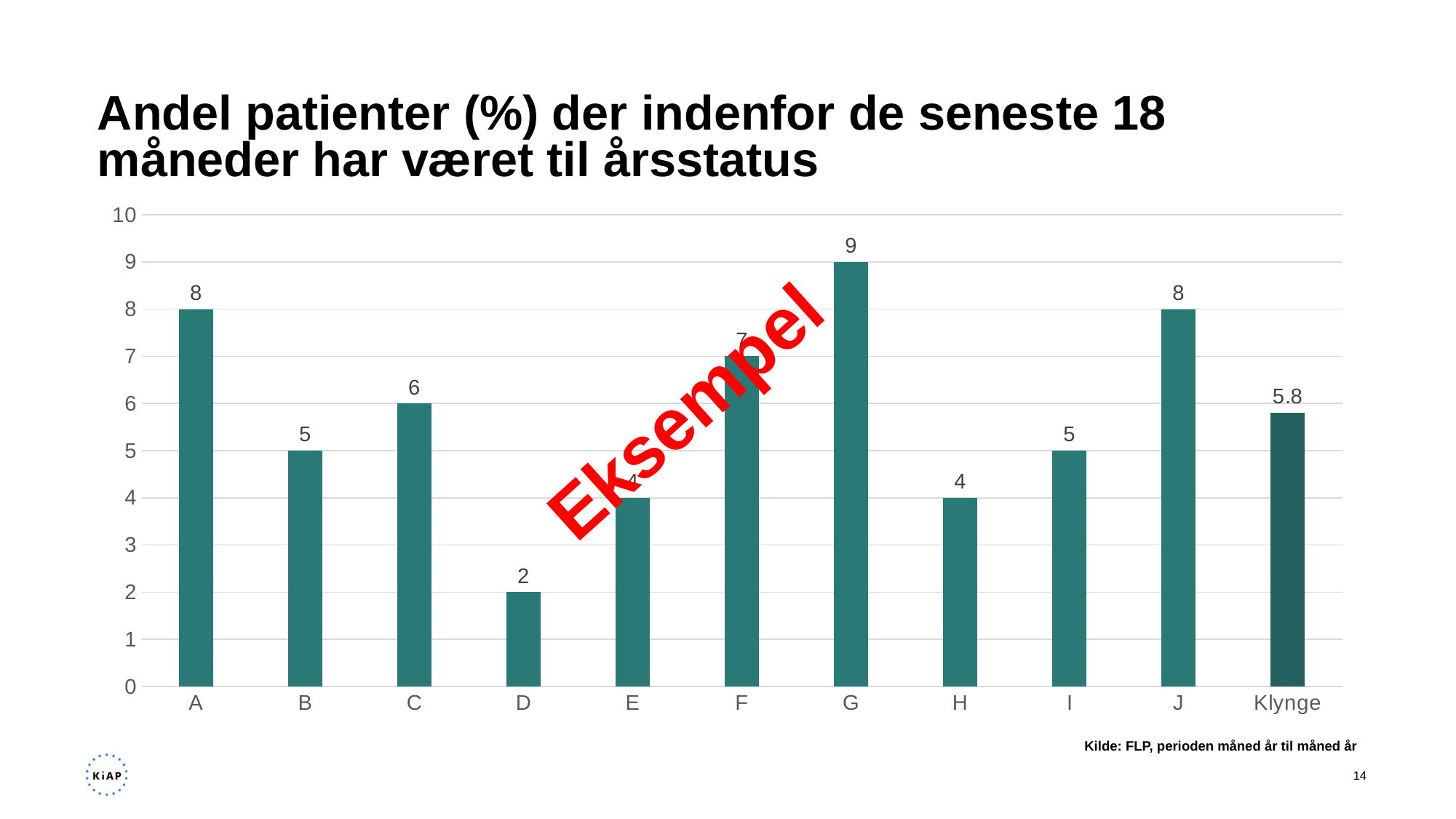
Which is larger, the value for C or the value for H? C What is the title of the chart? Andel patienter (%) der indenfor de seneste 18 måneder har været til årsstatus Which category has the lowest value? D How many categories are shown on the x axis? 11 Which category has the highest value? G What is the difference between the values for G and D? 7 What is the value for category G? 9 What is the difference between the values for A and B? 3 Is the value for Klynge greater or less than 5? greater What is the value for Klynge? 5.8 What kind of chart is shown on the slide? Bar chart What is the value for category D? 2